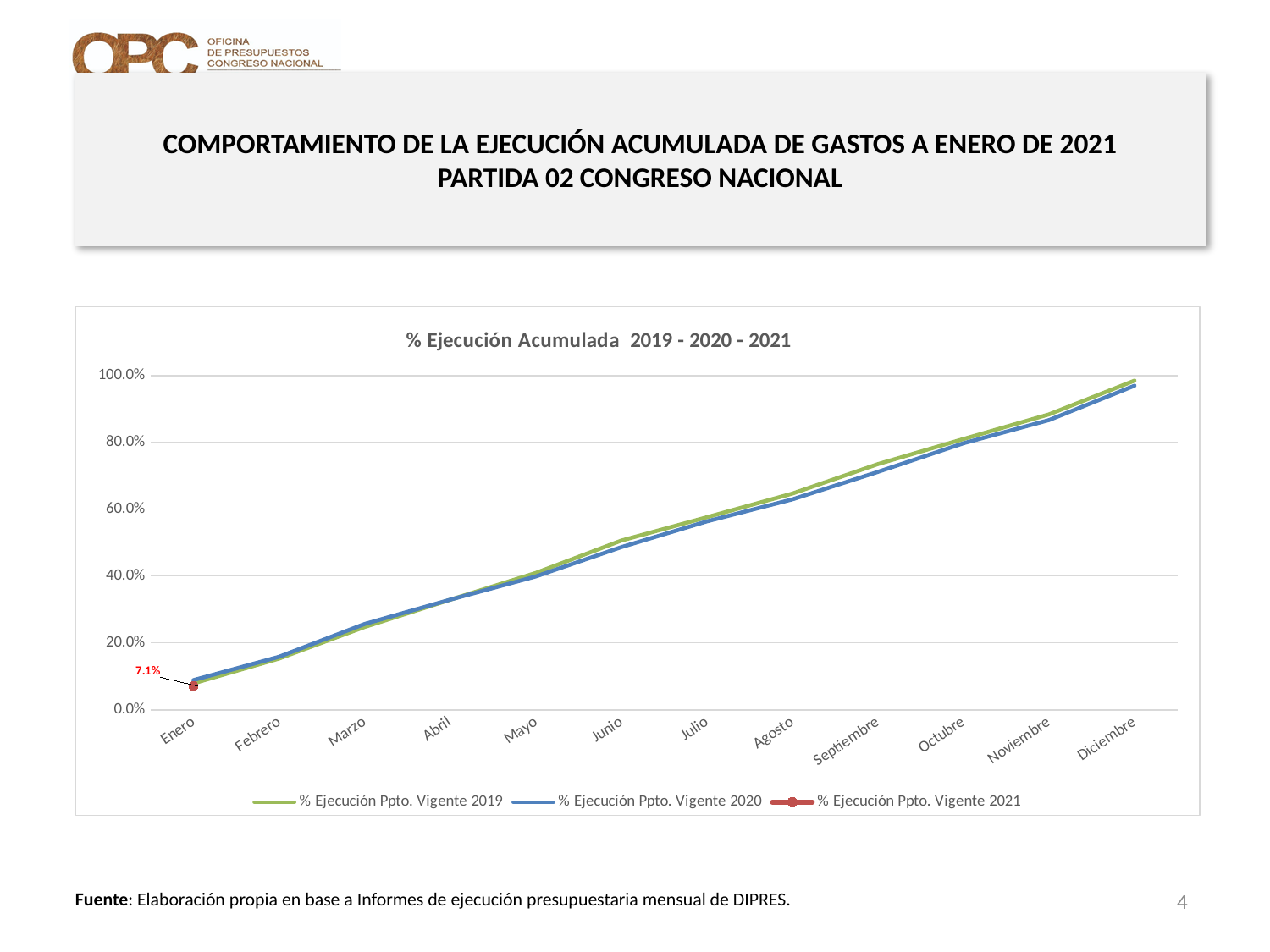
What is the title of the chart? % Ejecución Acumulada 2019 - 2020 - 2021 Is the value for % Ejecución Ppto. Vigente 2019 in Diciembre greater or less than 80.0%? greater What is the value of % Ejecución Ppto. Vigente 2021 for Enero? 7.1% Is the value for % Ejecución Ppto. Vigente 2019 in Junio greater or less than 40.0%? greater In which month is % Ejecución Ppto. Vigente 2020 at its lowest value? Enero In which month does % Ejecución Ppto. Vigente 2019 reach its highest value? Diciembre Do the values for % Ejecución Ppto. Vigente 2019 rise or fall from Enero to Diciembre? rise How many series does the legend of the chart list? 3 What kind of chart is shown on the slide? line chart Which is larger for % Ejecución Ppto. Vigente 2020: the value in Enero or the value in Diciembre? Diciembre Is the value for % Ejecución Ppto. Vigente 2020 in Enero greater or less than 20.0%? less How many months are shown along the x axis of the chart? 12